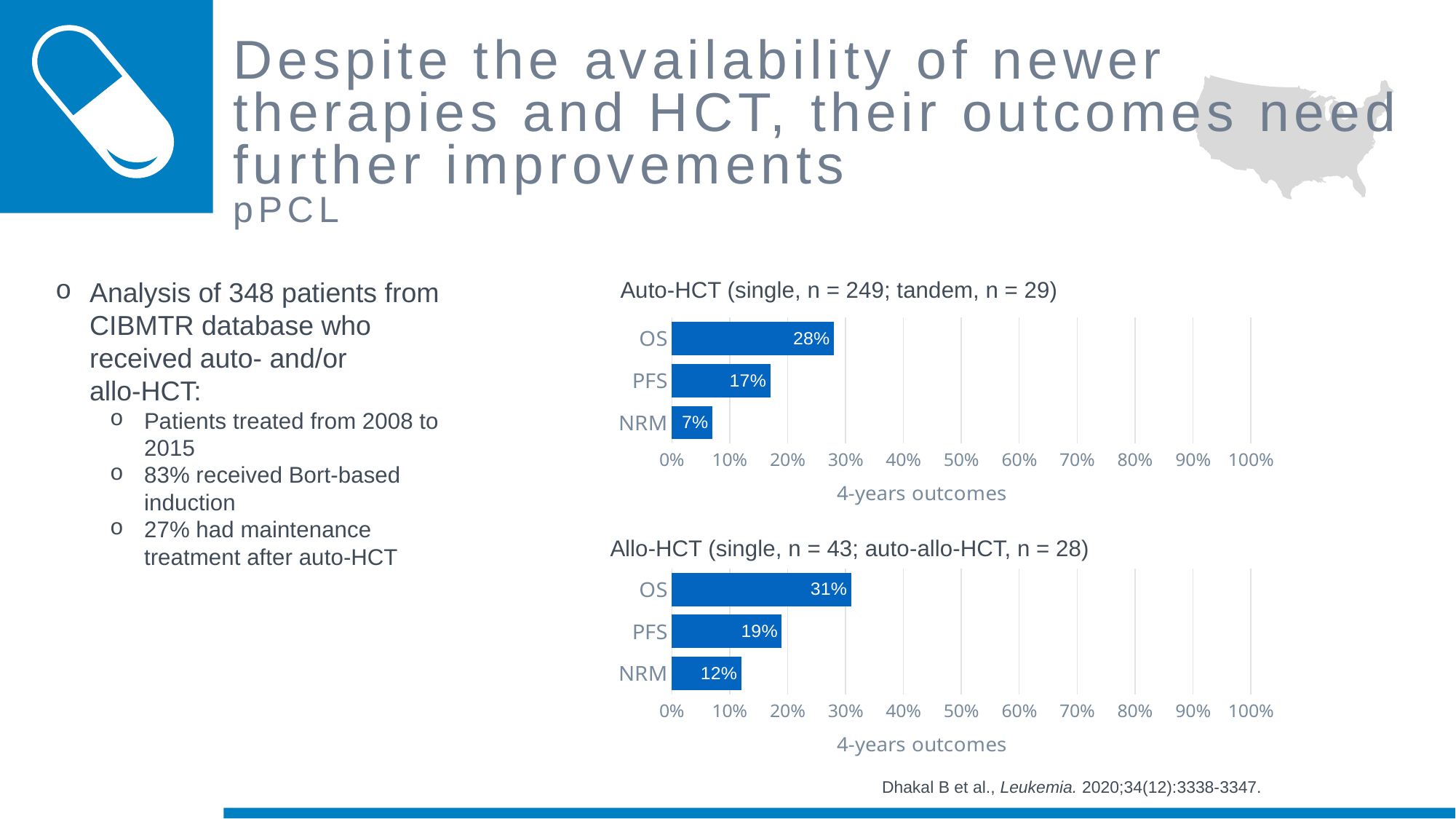
Which is larger: the PFS value in the Auto-HCT chart or the PFS value in the Allo-HCT chart? Allo-HCT In the Allo-HCT chart, which outcome has the highest value? OS In the Auto-HCT chart, which outcome has the lowest value? NRM How many outcome categories are shown in the Auto-HCT chart? 3 In the Auto-HCT chart, what is the 4-year OS value? 28% What type of chart is used to show the Allo-HCT outcomes? Bar chart In the Auto-HCT chart, what is the difference between the OS and PFS values? 11% In the Allo-HCT chart, what is the 4-year OS value? 31% In the Allo-HCT chart, is the OS value greater or less than 30%? greater In the Auto-HCT chart, what is the 4-year PFS value? 17% In the Allo-HCT chart, what is the 4-year NRM value? 12% What is the difference between the NRM value in the Allo-HCT chart and the NRM value in the Auto-HCT chart? 5%